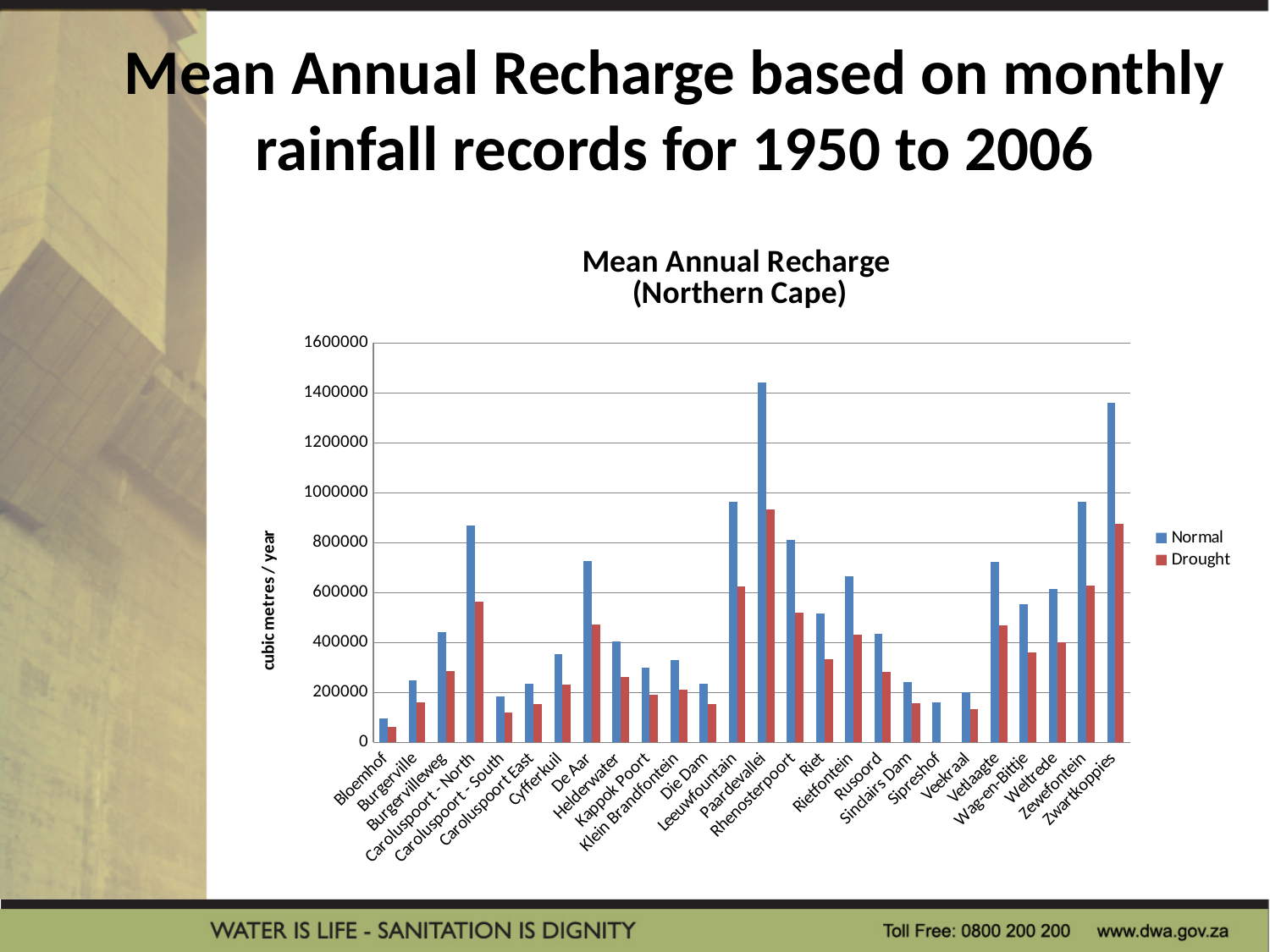
Which is larger, the Normal value for Caroluspoort - North or the Normal value for Caroluspoort - South? Caroluspoort - North Which location has the highest Drought mean annual recharge? Paardevallei Which is larger, the Normal value for De Aar or the Normal value for Helderwater? De Aar What is the label on the vertical axis of the chart? cubic metres / year Is the Normal value for Zwartkoppies greater or less than 1400000? less How many locations (categories) are plotted along the x axis? 26 What kind of chart is shown on the slide? Bar chart Which location has the highest Normal mean annual recharge? Paardevallei Is the Normal value for Caroluspoort - North greater or less than 800000? greater Is the Drought value for Zwartkoppies greater or less than 800000? greater Which location has the lowest Normal mean annual recharge? Bloemhof How many series does the legend list? 2